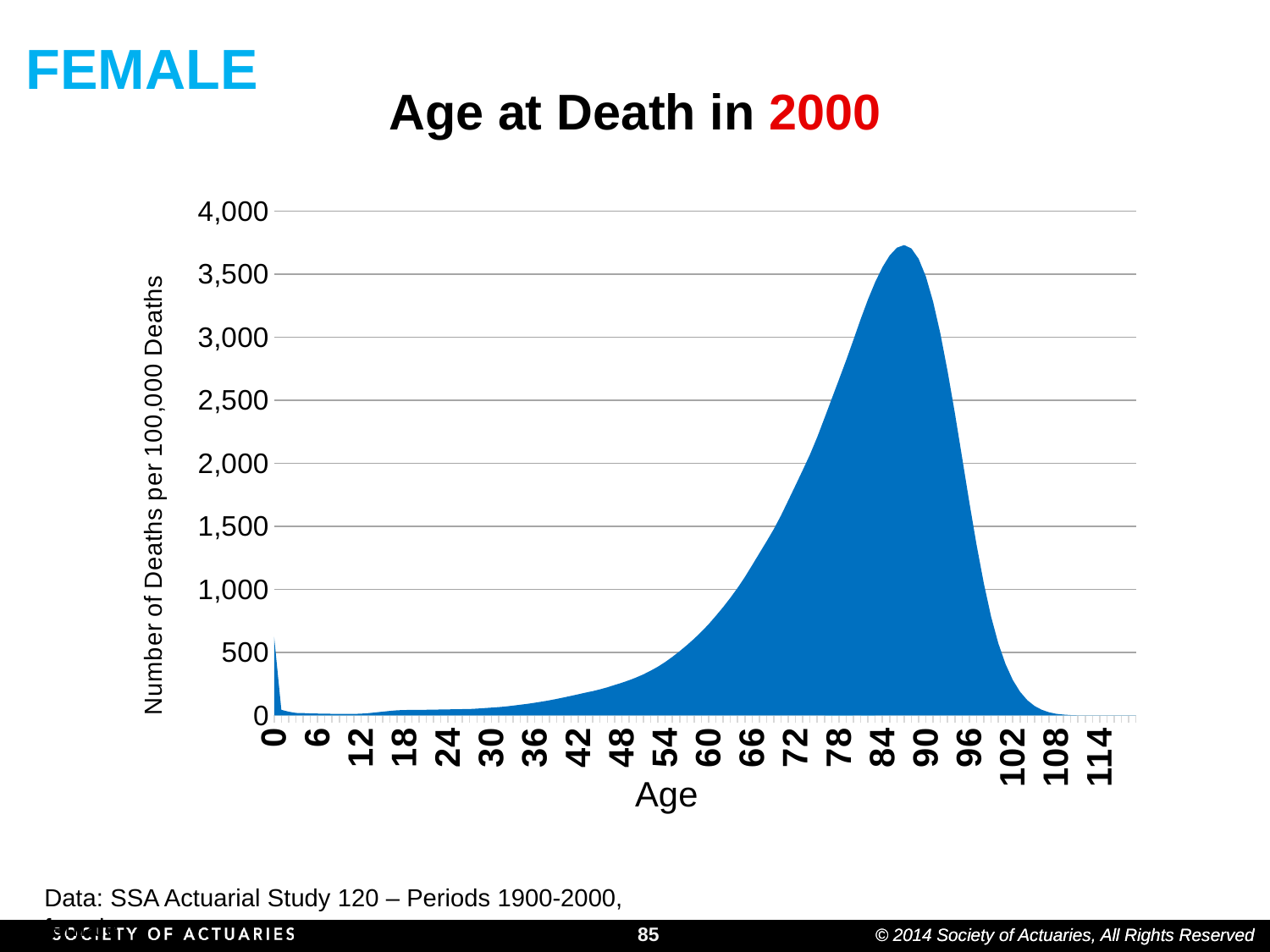
What is the title of the chart? Age at Death in 2000 Is the value at age 102 greater or less than 500? less Do the values rise or fall along the x axis between age 90 and age 108? fall What kind of chart is shown on the slide? Area chart Is the peak value of the curve greater or less than 3,500? greater Which age has the larger value, 60 or 84? 84 Which age has the larger value, 78 or 96? 78 Do the values rise or fall along the x axis between age 42 and age 84? rise Is the value at age 84 greater or less than 3,000? greater What is the label of the vertical axis? Number of Deaths per 100,000 Deaths